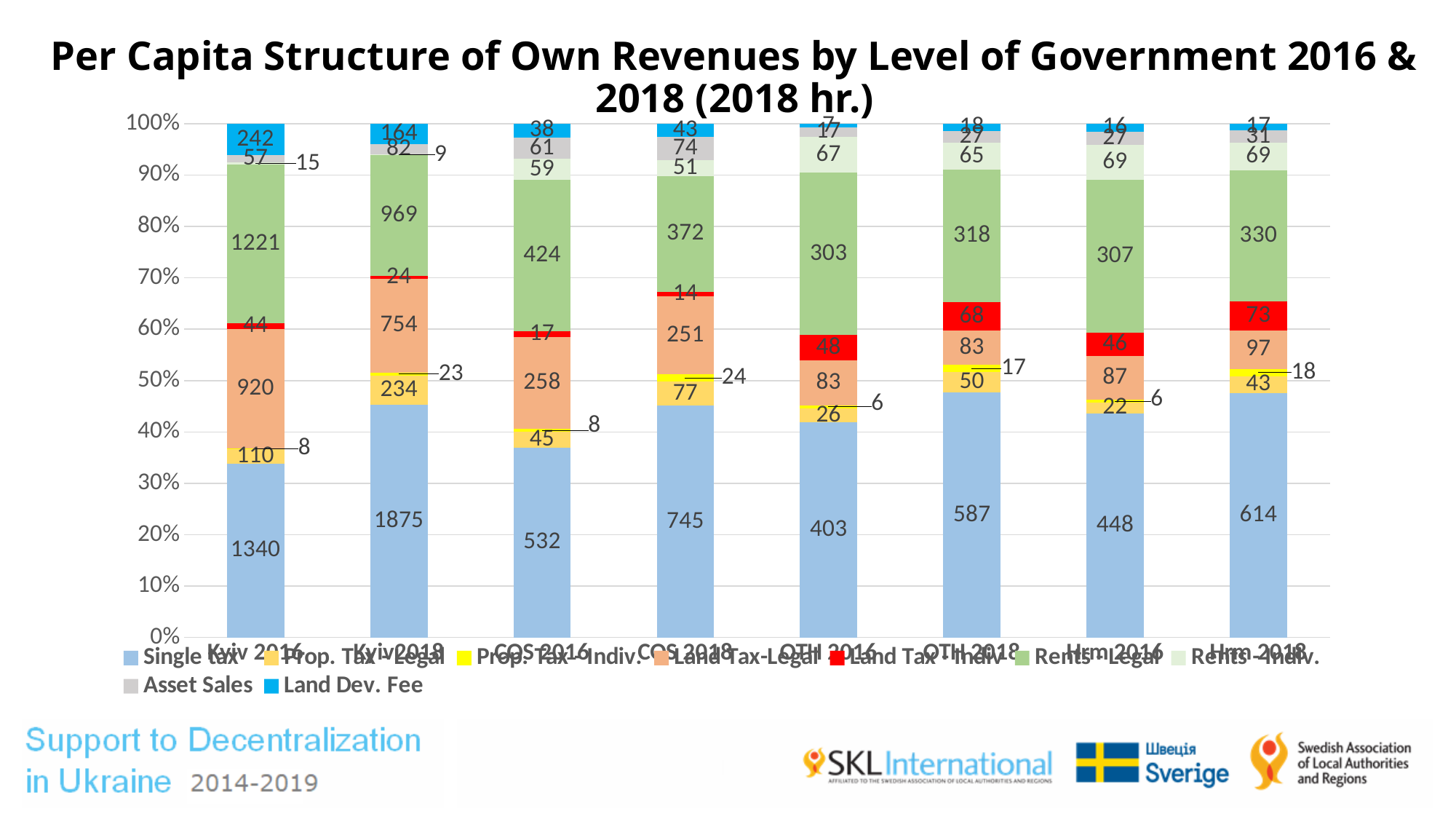
What is the difference between the Single tax values for Kyiv 2018 and Kyiv 2016? 535 What is the Land Dev. Fee value for Kyiv 2016? 242 What is the Rents - Legal value for Kyiv 2016? 1221 Which category has the lowest Single tax value? OTH 2016 How many series does the legend list? 9 How many categories are shown on the x axis? 8 Which has the larger Single tax value, COS 2018 or Hrm 2018? COS 2018 Which category has the highest Single tax value? Kyiv 2018 What kind of chart is shown on the slide? Stacked bar chart What is the Land Tax - Indiv. value for OTH 2018? 68 What is the Land Tax-Legal value for COS 2016? 258 What is the Single tax value for Kyiv 2018? 1875